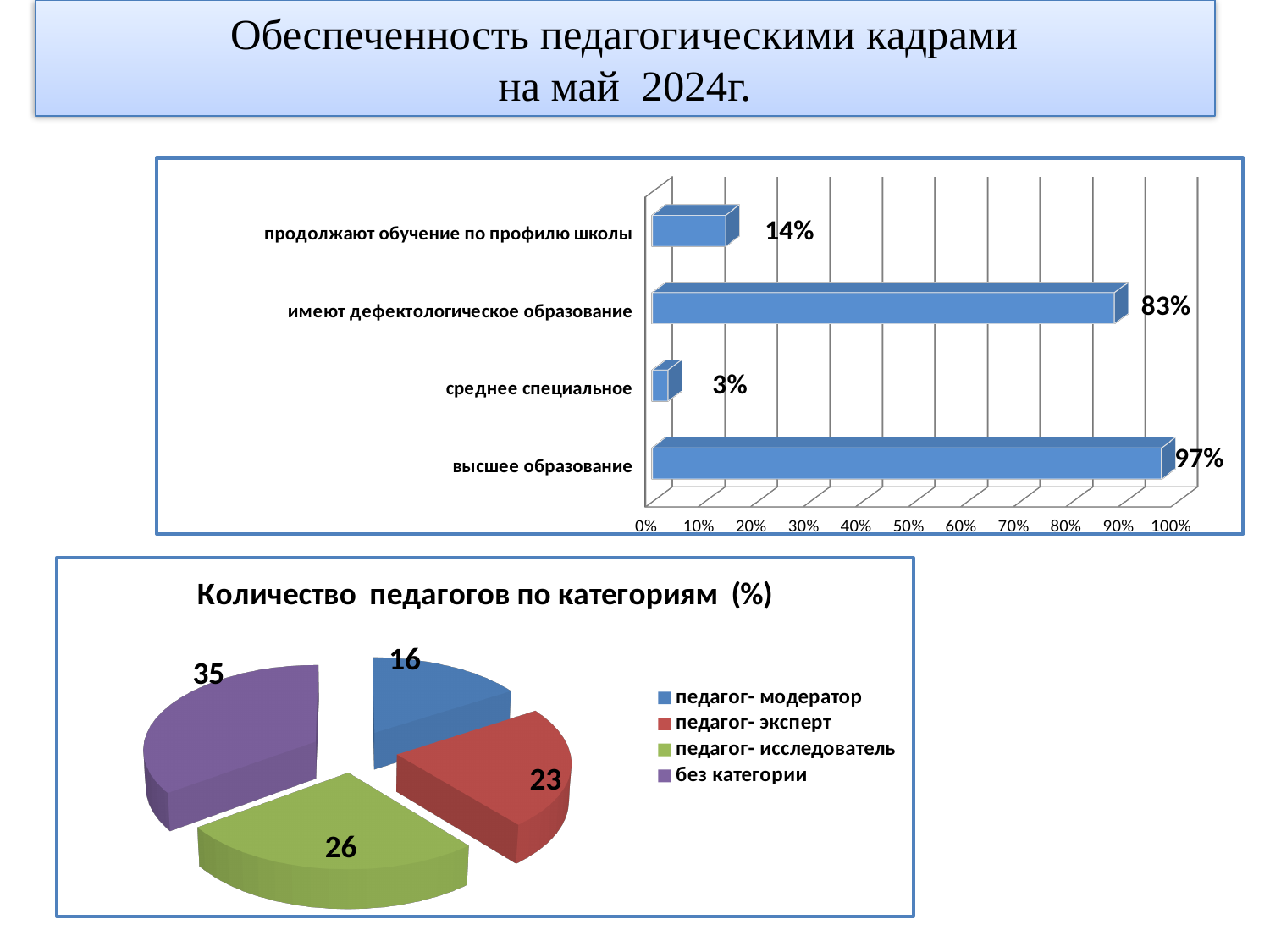
In the top bar chart, which category has the highest value? высшее образование In the top bar chart, what is the value for 'высшее образование'? 97% In the pie chart 'Количество педагогов по категориям (%)', what is the value for 'педагог- эксперт'? 23 In the top bar chart, how many categories are shown? 4 In the pie chart 'Количество педагогов по категориям (%)', which category has the largest slice? без категории What kind of chart is the top chart on the slide? Bar chart How many entries does the legend of the pie chart 'Количество педагогов по категориям (%)' list? 4 In the pie chart 'Количество педагогов по категориям (%)', what colour is the slice for 'без категории'? Purple In the pie chart 'Количество педагогов по категориям (%)', which is larger: 'педагог- модератор' or 'педагог- исследователь'? педагог- исследователь In the top bar chart, which category has the lowest value? среднее специальное In the top bar chart, what is the value for 'имеют дефектологическое образование'? 83% In the top bar chart, what is the difference between 'высшее образование' and 'имеют дефектологическое образование'? 14%